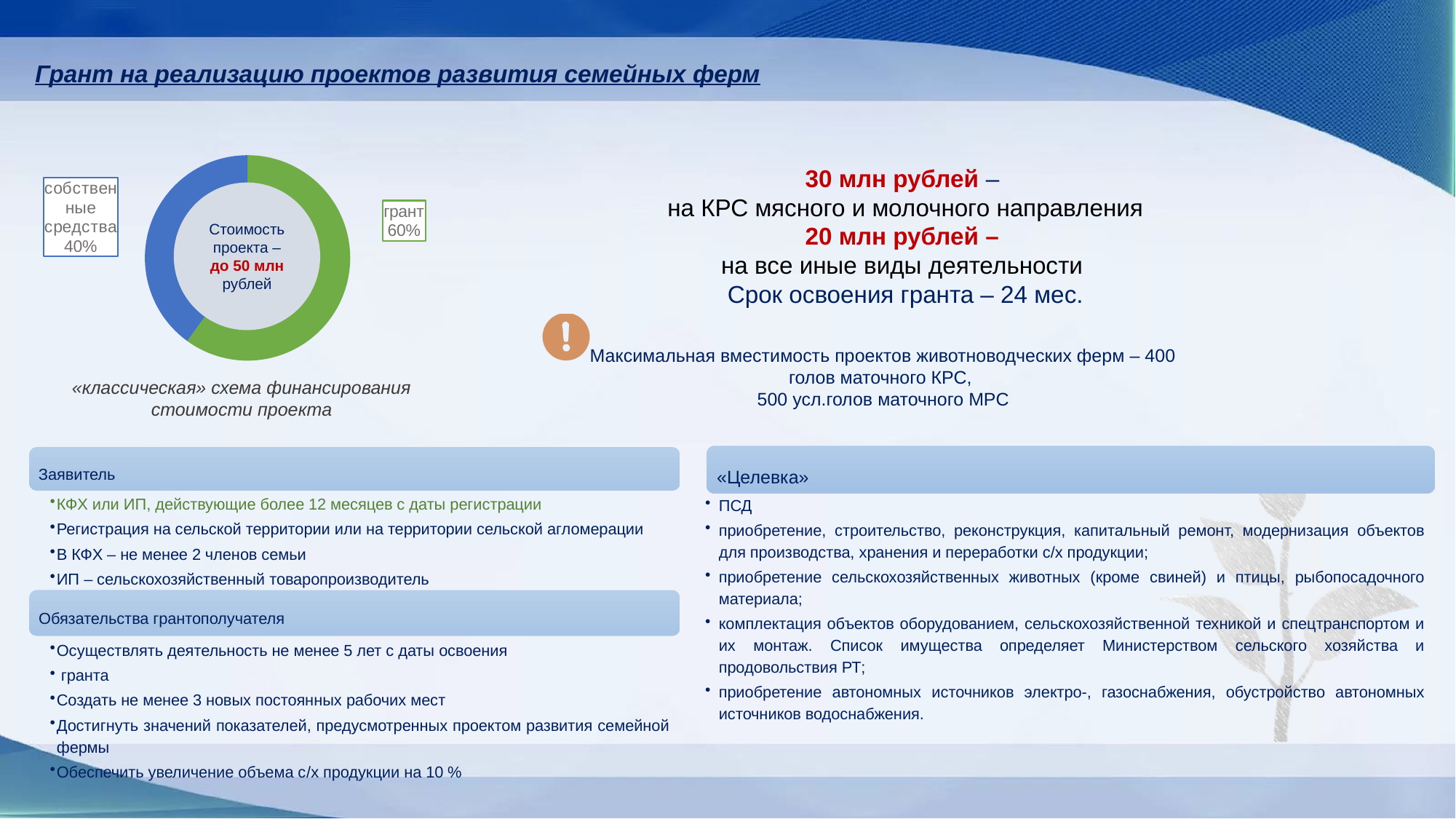
What is the combined share of the two slices in the doughnut chart? 100% What text is written in the centre of the doughnut chart? Стоимость проекта – до 50 млн рублей What type of chart is shown on the left of the slide? Doughnut (pie) chart By how many percentage points does the grant share exceed the own-funds share in the doughnut chart? 20 percentage points What colour is the грант slice in the doughnut chart? Green How many slices does the doughnut chart have? 2 What share of the project cost does the grant (грант) cover in the doughnut chart? 60% Which slice of the doughnut chart is larger: грант or собственные средства? грант What share of the project cost comes from own funds (собственные средства) in the doughnut chart? 40% Which category has the largest share in the doughnut chart? грант Which category has the smallest share in the doughnut chart? собственные средства